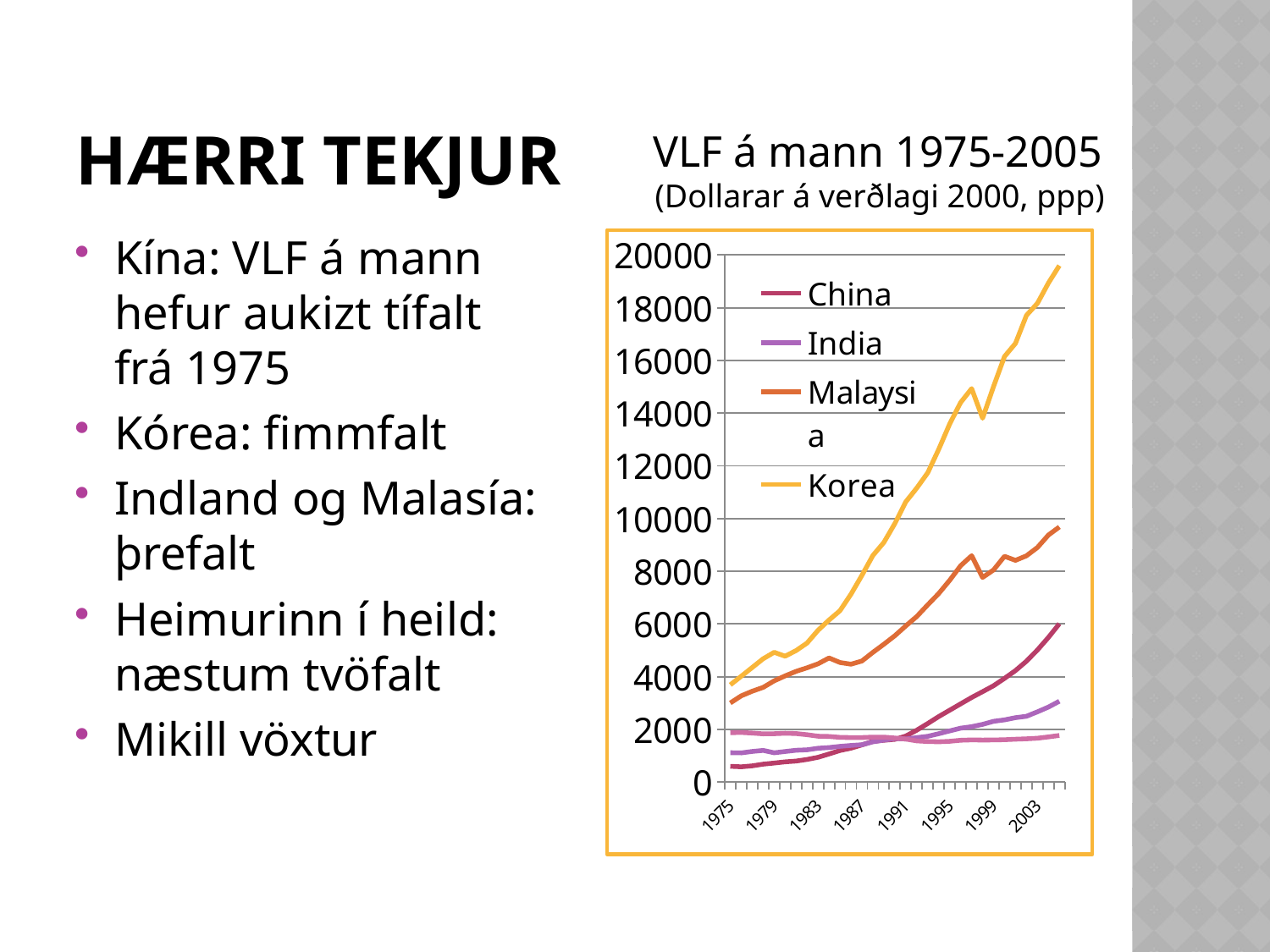
Is the value for Korea in 2005 greater or less than 18000? greater Which is larger in 2005, the value for Korea or the value for Malaysia? Korea Is the value for Malaysia in 2005 greater or less than 8000? greater What is the title of the chart? VLF á mann 1975-2005 (Dollarar á verðlagi 2000, ppp) What colour is the line for Korea? yellow How many series does the chart legend list? 4 What kind of chart is shown on the slide? line chart Which series has the highest value in 2005? Korea Which of the legend series has the lowest value in 1975? China Is the value for China in 1975 greater or less than 2000? less Does the value for Korea generally rise or fall from 1975 to 2005? rise